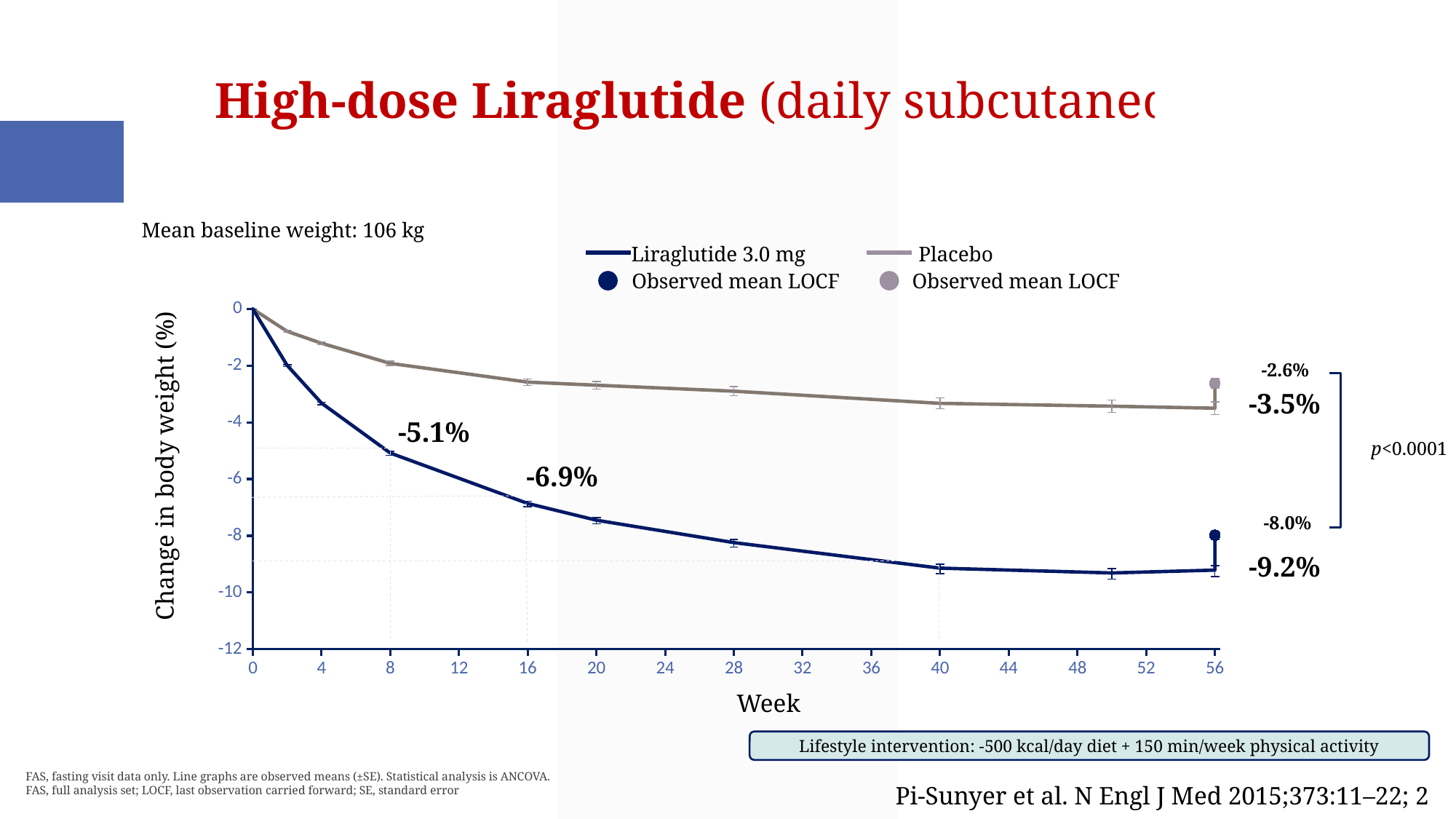
What is the change in body weight for Placebo at week 56? -3.5% What is the change in body weight for Liraglutide 3.0 mg at week 8? -5.1% What kind of chart is shown on the slide? line chart Is the Placebo value at week 28 greater or less than -2? less Does the Liraglutide 3.0 mg line rise or fall from week 0 to week 40? fall What is the difference between the Liraglutide 3.0 mg and Placebo values at week 56 (-9.2% vs -3.5%)? 5.7 percentage points Which group shows the larger reduction in body weight at week 56, Liraglutide 3.0 mg or Placebo? Liraglutide 3.0 mg How many entries does the chart legend list? 4 What is the change in body weight for Liraglutide 3.0 mg at week 16? -6.9% What is the observed mean LOCF value for Liraglutide 3.0 mg at week 56? -8.0% What is the change in body weight for Liraglutide 3.0 mg at week 56? -9.2% What is the observed mean LOCF value for Placebo at week 56? -2.6%